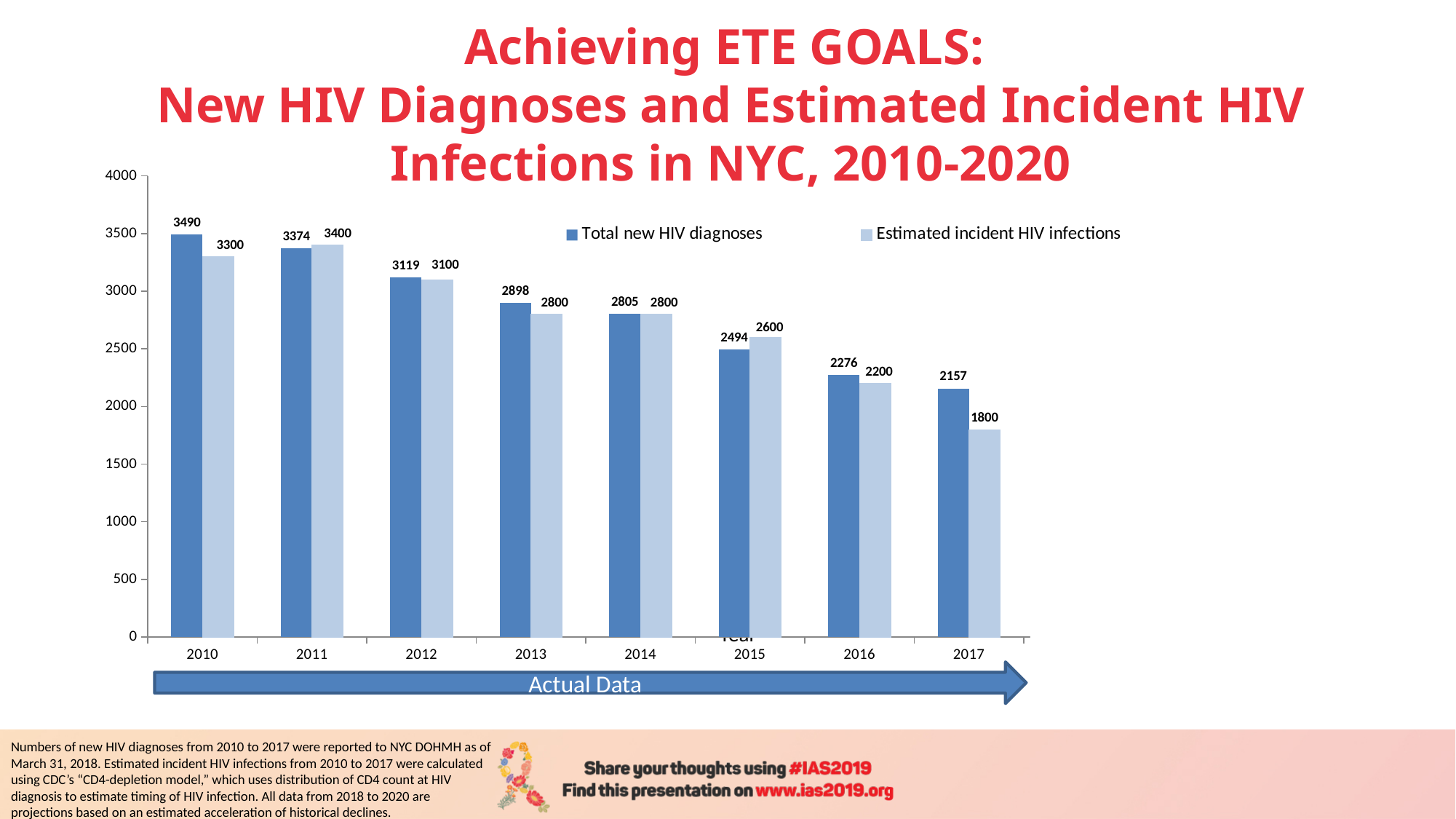
What is the value for Estimated incident HIV infections in 2017? 1800 What is the value for Total new HIV diagnoses in 2010? 3490 How many series does the legend list? 2 Is the value for Total new HIV diagnoses in 2016 greater or less than 2500? less Do the values for Total new HIV diagnoses rise or fall from 2010 to 2017? fall How many years are shown on the x axis? 8 Which is larger in 2015: Total new HIV diagnoses or Estimated incident HIV infections? Estimated incident HIV infections Which year has the lowest value for Estimated incident HIV infections? 2017 What kind of chart is shown on the slide? bar chart What is the value for Total new HIV diagnoses in 2015? 2494 Which year has the highest value for Total new HIV diagnoses? 2010 What is the difference between Total new HIV diagnoses in 2010 and in 2017? 1333